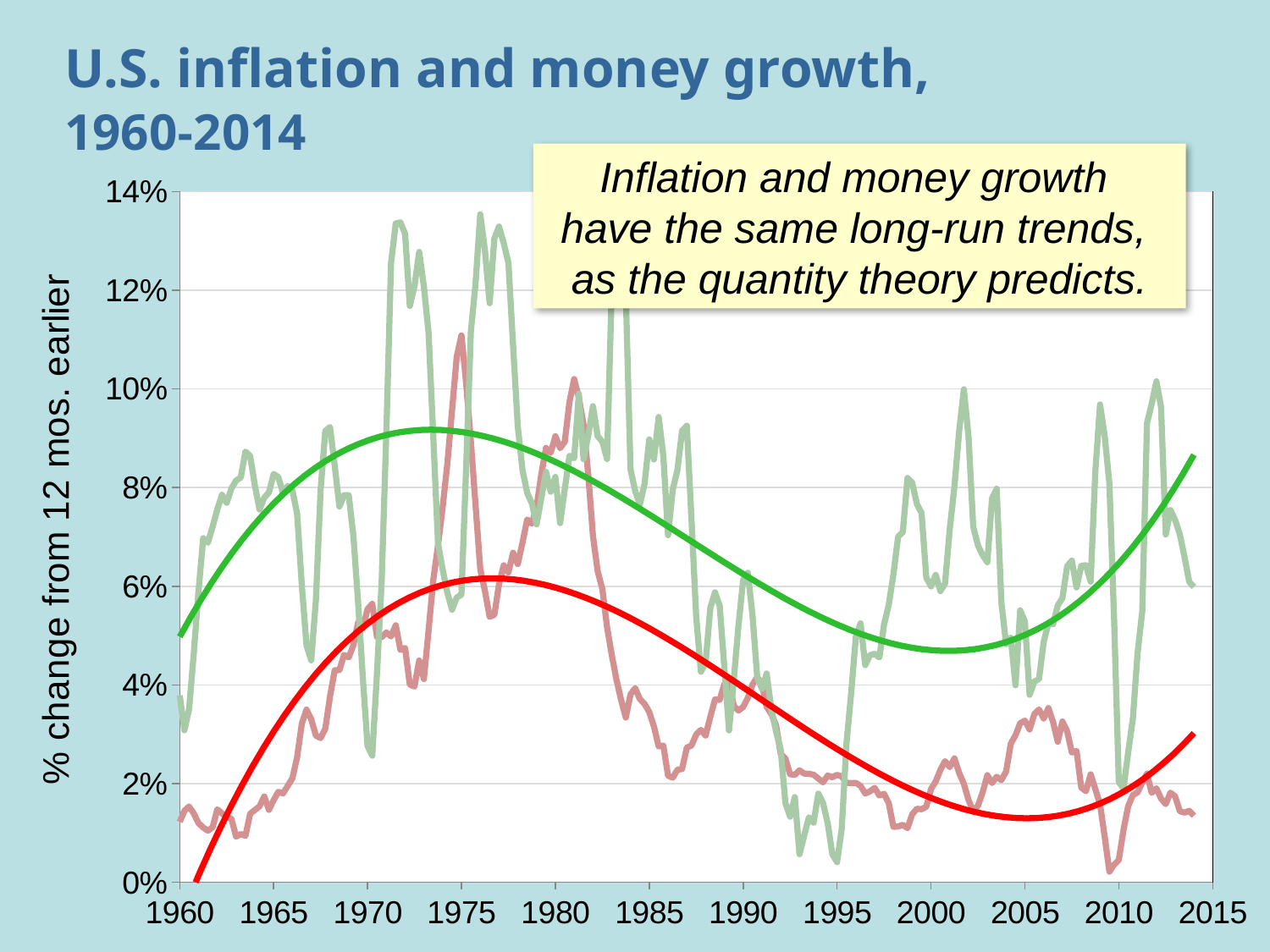
What is the label on the vertical axis of the chart? % change from 12 mos. earlier Is the value of the smooth green trend line at 2000 greater or less than 6%? less Is the value of the smooth red trend line at 1980 greater or less than 4%? greater Is the value of the smooth red trend line at 2005 greater or less than 2%? less What is the last year shown on the horizontal axis of the chart? 2015 Does the smooth green trend line rise or fall between 1975 and 2000? fall Does the smooth red trend line rise or fall between 1960 and 1975? rise What kind of chart is shown on the slide? line chart What is the highest value shown on the vertical axis of the chart? 14% What is the title of the chart on the slide? U.S. inflation and money growth, 1960-2014 What is the first year shown on the horizontal axis of the chart? 1960